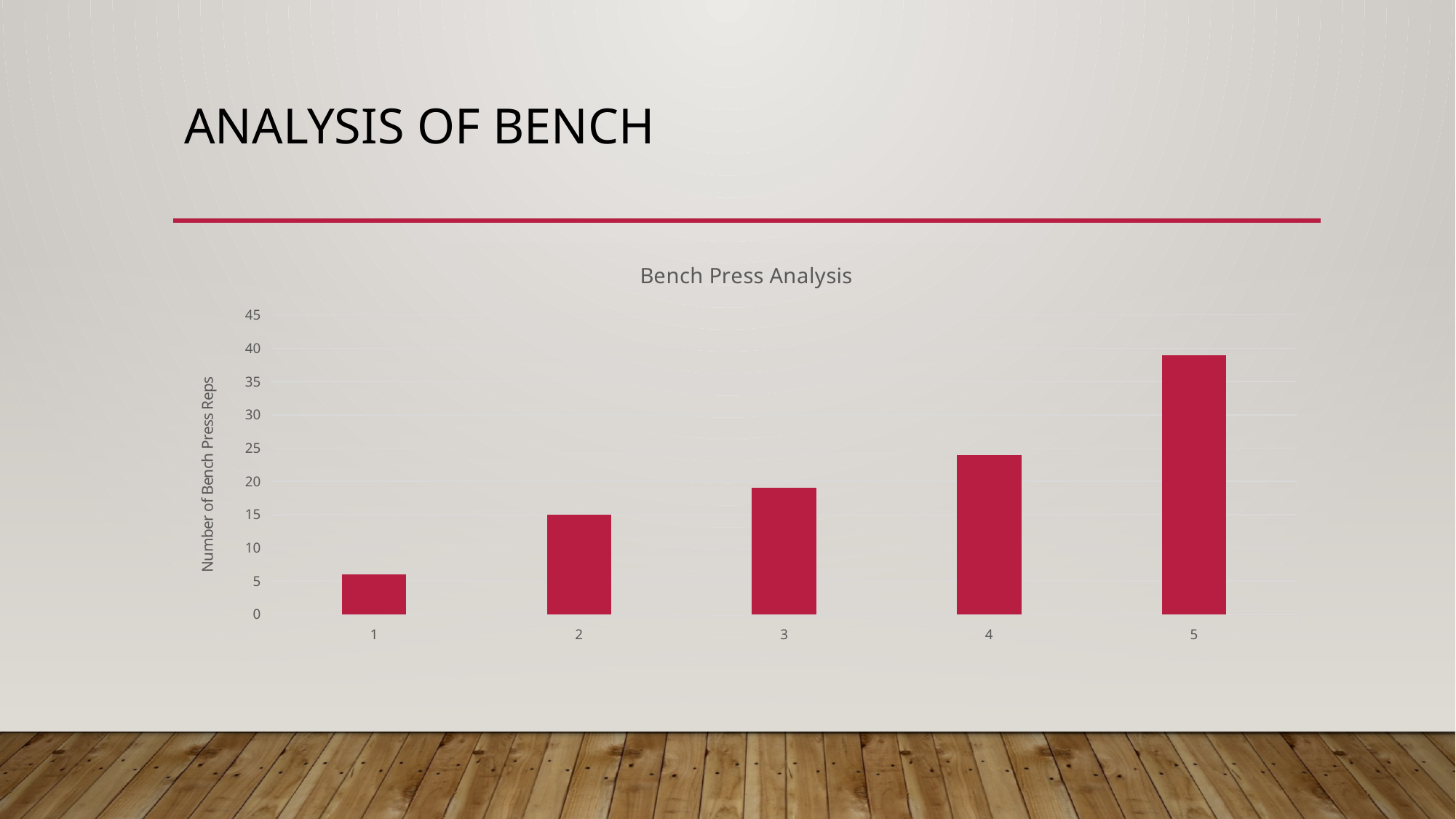
How many bars are plotted in the chart? 5 What is the number of bench press reps for category 2? 15 Which category has the highest number of bench press reps? 5 Do the values rise or fall from category 1 to category 5? rise Is the value for category 1 greater or less than 10? less Which category has the lowest number of bench press reps? 1 Is the value for category 5 greater or less than 35? greater Is the value for category 3 greater or less than 15? greater What is the title of the chart? Bench Press Analysis What is the label on the vertical axis of the chart? Number of Bench Press Reps Which has more bench press reps, category 4 or category 3? 4 What kind of chart is shown on the slide? bar chart